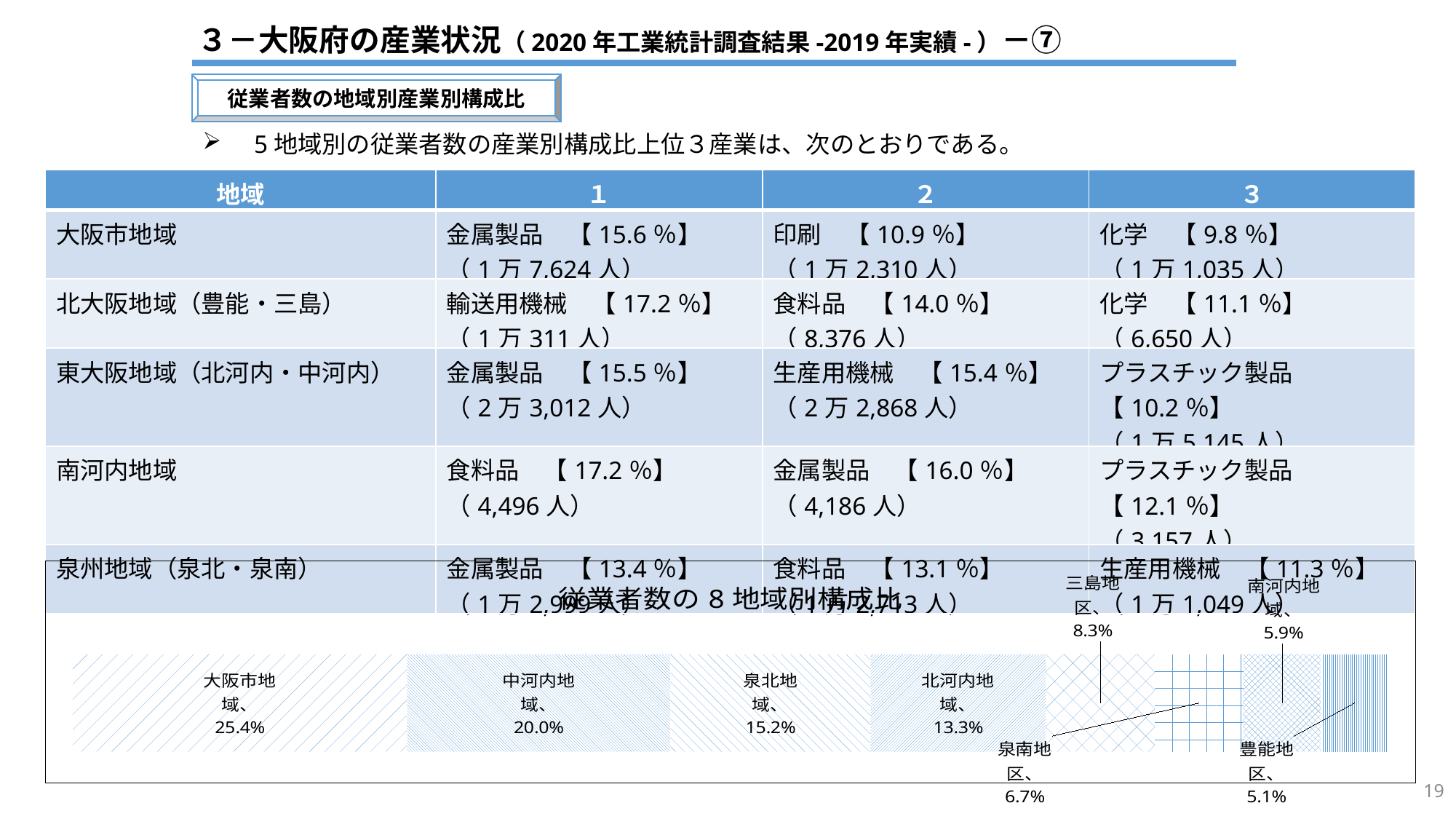
How many regions are shown in the chart 従業者数の8地域別構成比? 8 In the chart 従業者数の8地域別構成比, which region has the largest share? 大阪市地域 In the chart 従業者数の8地域別構成比, what is the share for 豊能地区? 5.1% In the chart 従業者数の8地域別構成比, what is the share for 中河内地域? 20.0% In the chart 従業者数の8地域別構成比, which region has the smallest share? 豊能地区 What kind of chart is 従業者数の8地域別構成比? Stacked bar chart In the chart 従業者数の8地域別構成比, which has the larger share, 泉南地区 or 三島地区? 三島地区 In the chart 従業者数の8地域別構成比, what is the share for 三島地区? 8.3% In the chart 従業者数の8地域別構成比, what is the share for 大阪市地域? 25.4% In the chart 従業者数の8地域別構成比, what is the share for 泉北地域? 15.2% In the chart 従業者数の8地域別構成比, what is the share for 北河内地域? 13.3% In the chart 従業者数の8地域別構成比, what is the difference between the shares of 大阪市地域 and 中河内地域? 5.4 percentage points